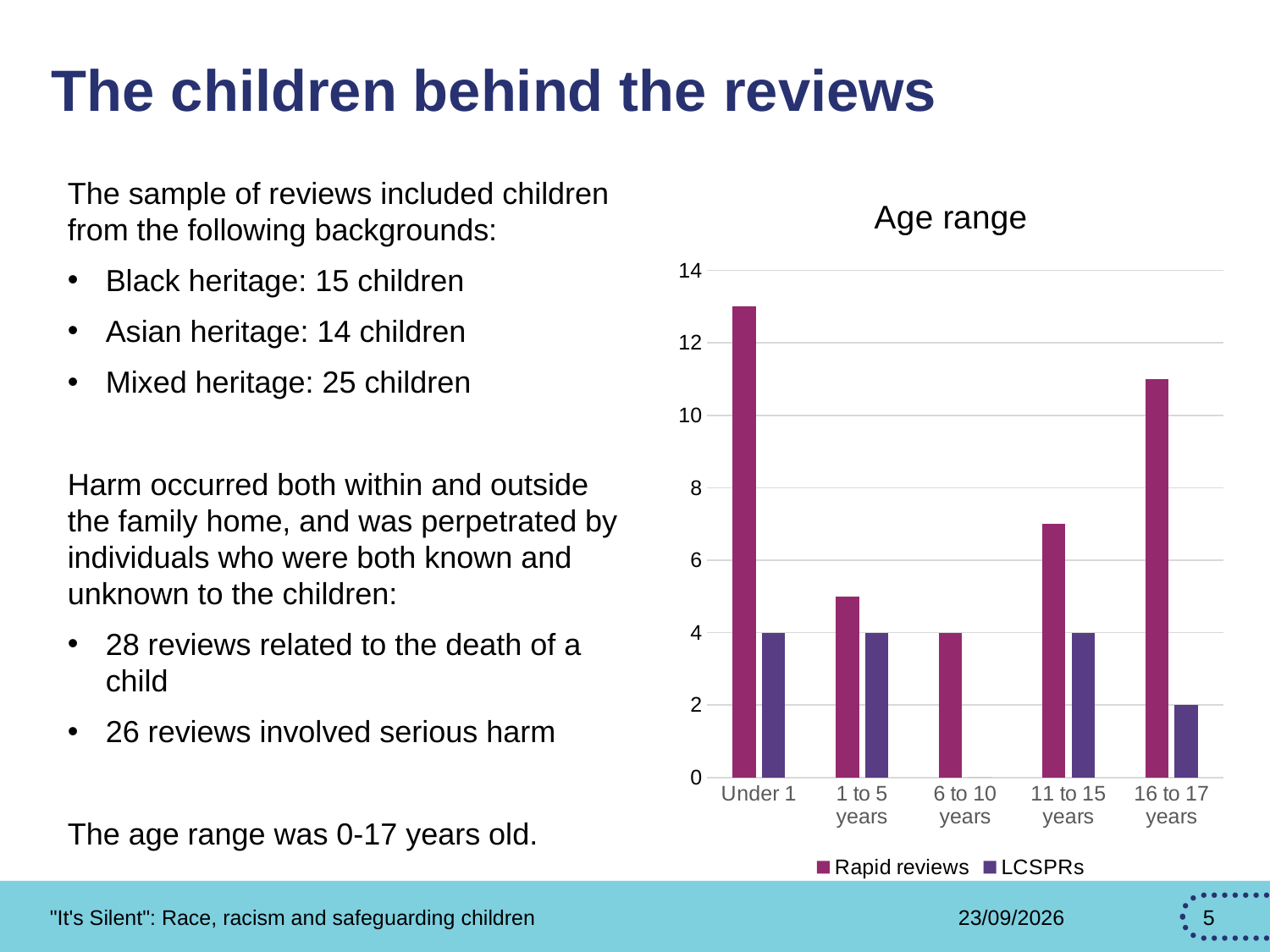
What kind of chart is shown on the slide? bar chart Which age category has the highest value for Rapid reviews? Under 1 What is the title of the chart? Age range Is the Rapid reviews value for 16 to 17 years greater or less than 10? greater Which age category has the lowest value for Rapid reviews? 6 to 10 years How many age categories are shown on the x axis of the chart? 5 Is the Rapid reviews value for Under 1 greater or less than 12? greater For 11 to 15 years, which series has the larger value, Rapid reviews or LCSPRs? Rapid reviews What is the LCSPRs value for 16 to 17 years? 2 What is the LCSPRs value for Under 1? 4 What is the Rapid reviews value for 6 to 10 years? 4 How many series does the chart's legend list? 2